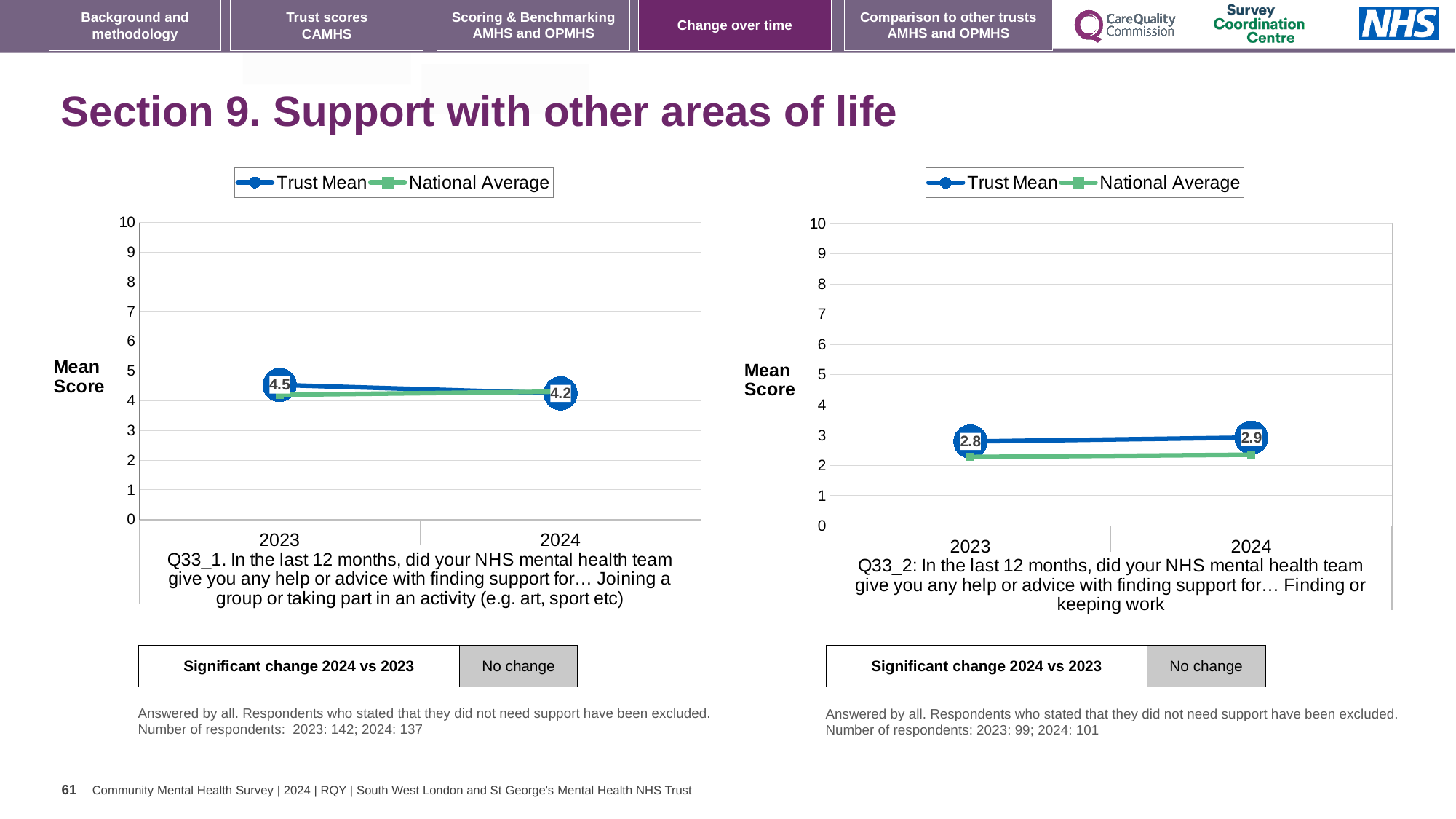
In the right chart (Q33_2), which is larger for 2024, the Trust Mean or the National Average? Trust Mean In the right chart (Q33_2), is the National Average value for 2023 greater or less than 3? less What kind of chart is the left chart (Q33_1)? line chart In the left chart (Q33_1), by how much did the Trust Mean change from 2023 to 2024? 0.3 How many series does the legend of the right chart (Q33_2) list? 2 In the left chart (Q33_1), what is the Trust Mean score for 2023? 4.5 In the right chart (Q33_2), what is the Trust Mean score for 2024? 2.9 In the left chart (Q33_1), does the Trust Mean rise or fall from 2023 to 2024? fall How many years are plotted on the x axis of the right chart (Q33_2)? 2 In the right chart (Q33_2), what is the Trust Mean score for 2023? 2.8 In the right chart (Q33_2), does the Trust Mean rise or fall from 2023 to 2024? rise In the left chart (Q33_1), what is the Trust Mean score for 2024? 4.2